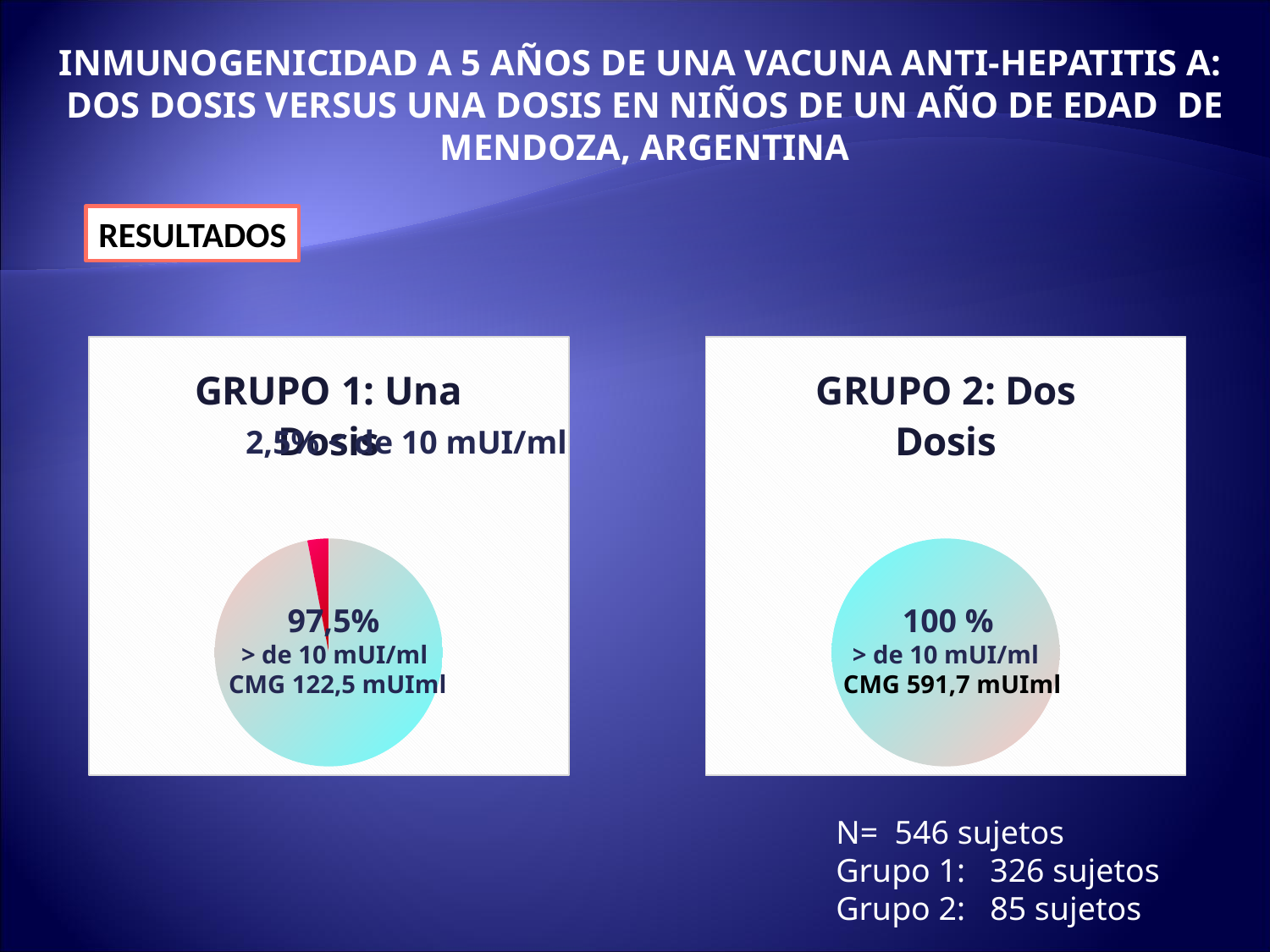
In the GRUPO 1: Una Dosis chart, what share of subjects had > de 10 mUI/ml? 97,5% In the GRUPO 2: Dos Dosis chart, what share of subjects had > de 10 mUI/ml? 100 % How many slices does the GRUPO 1: Una Dosis pie chart have? 2 In the GRUPO 1: Una Dosis chart, what is the CMG value printed on the pie? CMG 122,5 mUIml In the GRUPO 1: Una Dosis chart, what share of subjects had < de 10 mUI/ml? 2,5% In the GRUPO 2: Dos Dosis chart, what is the CMG value printed on the pie? CMG 591,7 mUIml Which group's chart shows the larger share of subjects with > de 10 mUI/ml, GRUPO 1 or GRUPO 2? GRUPO 2 What kind of chart is shown in the GRUPO 2: Dos Dosis panel? pie chart Which group's chart shows the higher CMG value, GRUPO 1 or GRUPO 2? GRUPO 2 What is the title of the chart on the right side of the slide? GRUPO 2: Dos Dosis What kind of chart is shown in the GRUPO 1: Una Dosis panel? pie chart How many slices does the GRUPO 2: Dos Dosis pie chart have? 1